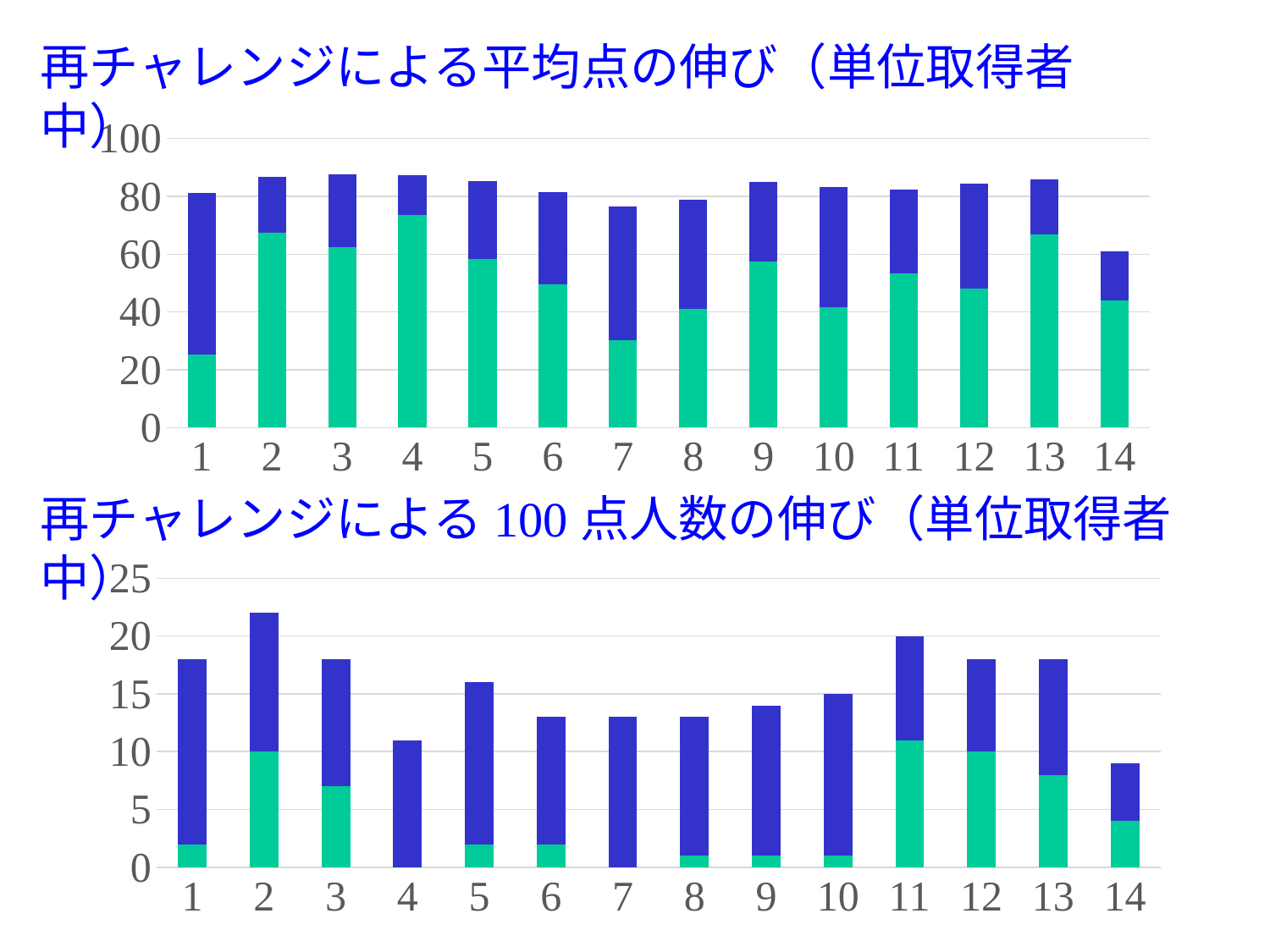
What is the title of the bottom chart on the slide? 再チャレンジによる 100 点人数の伸び（単位取得者中） How many categories are shown on the x axis of the bottom chart titled 再チャレンジによる 100 点人数の伸び（単位取得者中）? 14 What kind of chart is the top chart titled 再チャレンジによる平均点の伸び（単位取得者中）? Stacked bar chart In the top chart (平均点の伸び), is the green segment for category 7 greater or less than 40? less In the top chart (平均点の伸び), is the total value for category 14 greater or less than 80? less In the top chart (平均点の伸び), is the green segment for category 4 greater or less than 60? greater In the top chart (平均点の伸び), which has the larger total bar, category 1 or category 14? Category 1 In the bottom chart (100 点人数の伸び), which category has the lowest total bar? 14 In the top chart (平均点の伸び), which category has the lowest total bar? 14 In the bottom chart (100 点人数の伸び), which category has the highest total bar? 2